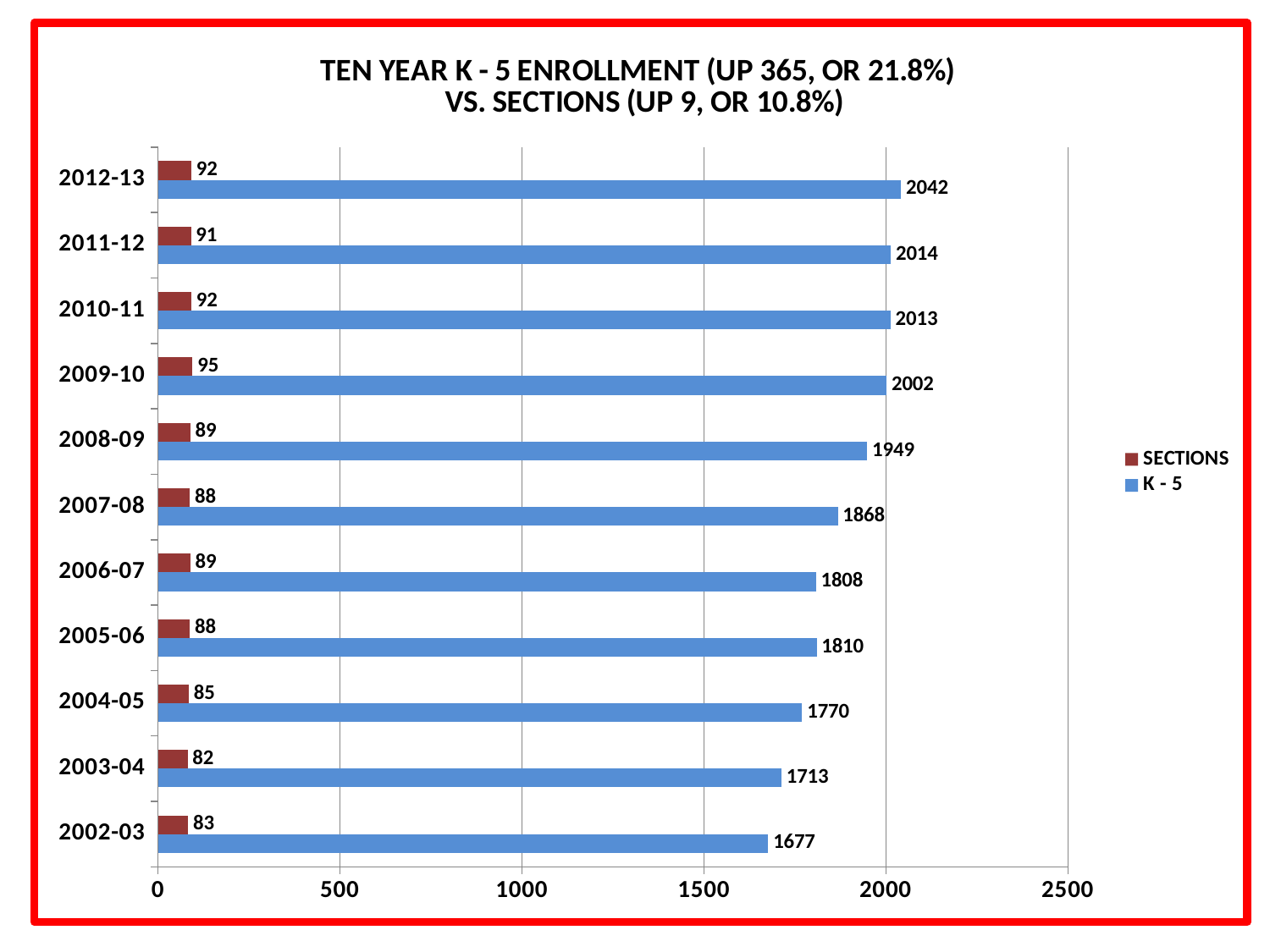
How many school years are shown on the chart? 11 Which school year has the lowest SECTIONS value? 2003-04 What kind of chart is shown on the slide? bar chart What colour are the K - 5 bars? blue What is the K - 5 enrollment value for 2012-13? 2042 What is the difference between the K - 5 values for 2012-13 and 2002-03? 365 How many series does the legend list? 2 Which is larger, the K - 5 value for 2005-06 or for 2006-07? 2005-06 Is the K - 5 value for 2008-09 greater or less than 2000? less Which school year has the highest K - 5 enrollment? 2012-13 What is the SECTIONS value for 2009-10? 95 What is the K - 5 value for 2002-03? 1677